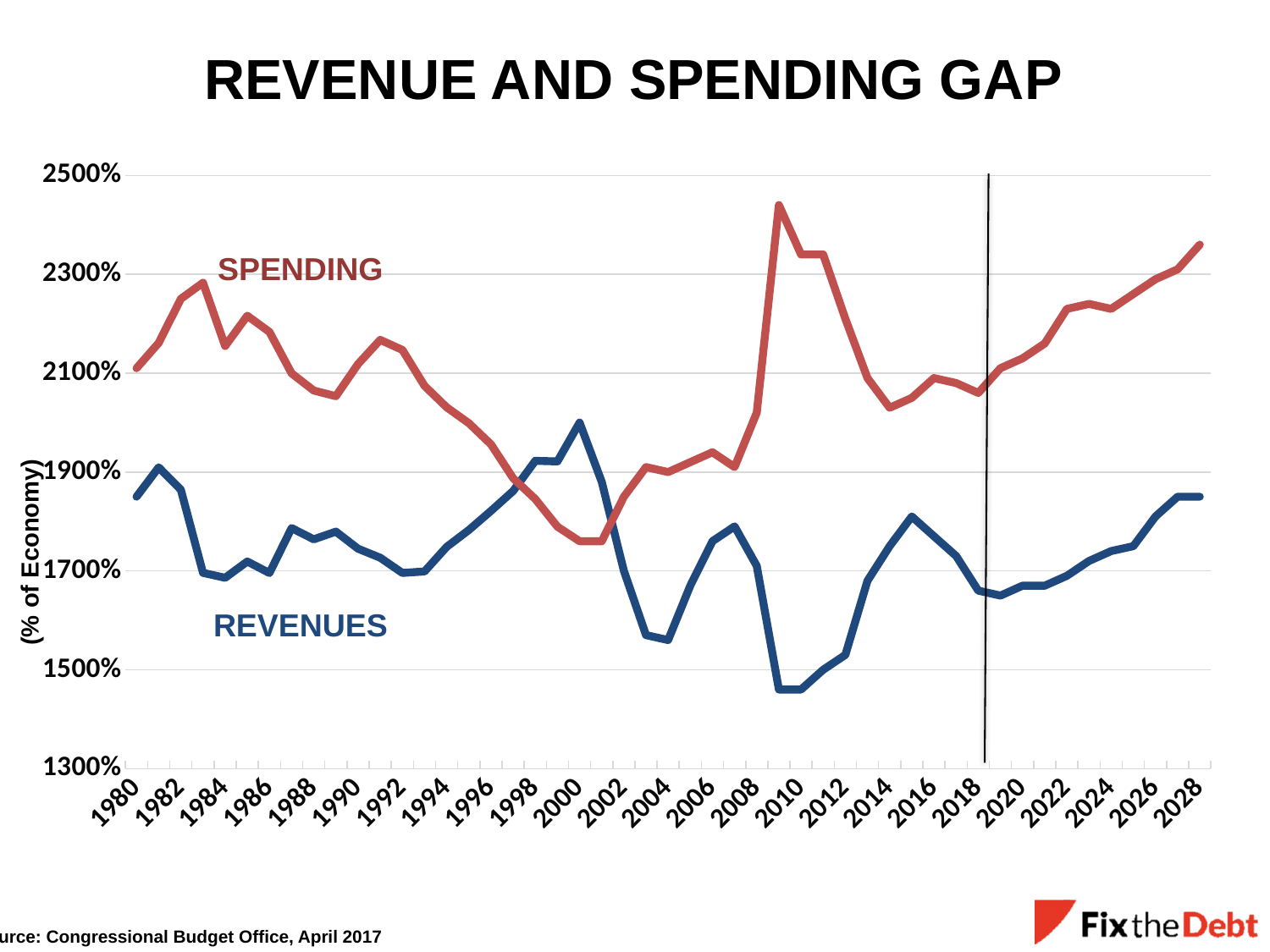
Which colour is used for the SPENDING line? red In 2010, which is higher, SPENDING or REVENUES? SPENDING What is the title of the chart? REVENUE AND SPENDING GAP Does the SPENDING line rise or fall from 2018 to 2028? rise Around which year does the SPENDING line reach its highest point? 2009 Is the REVENUES value around 2010 greater or less than 1500%? less Is the SPENDING value in 2028 greater or less than 2300%? greater How many series are plotted on the chart? 2 Is the REVENUES value in 2000 greater or less than 1900%? greater What kind of chart is shown on the slide? line chart In 2000, which is higher, SPENDING or REVENUES? REVENUES